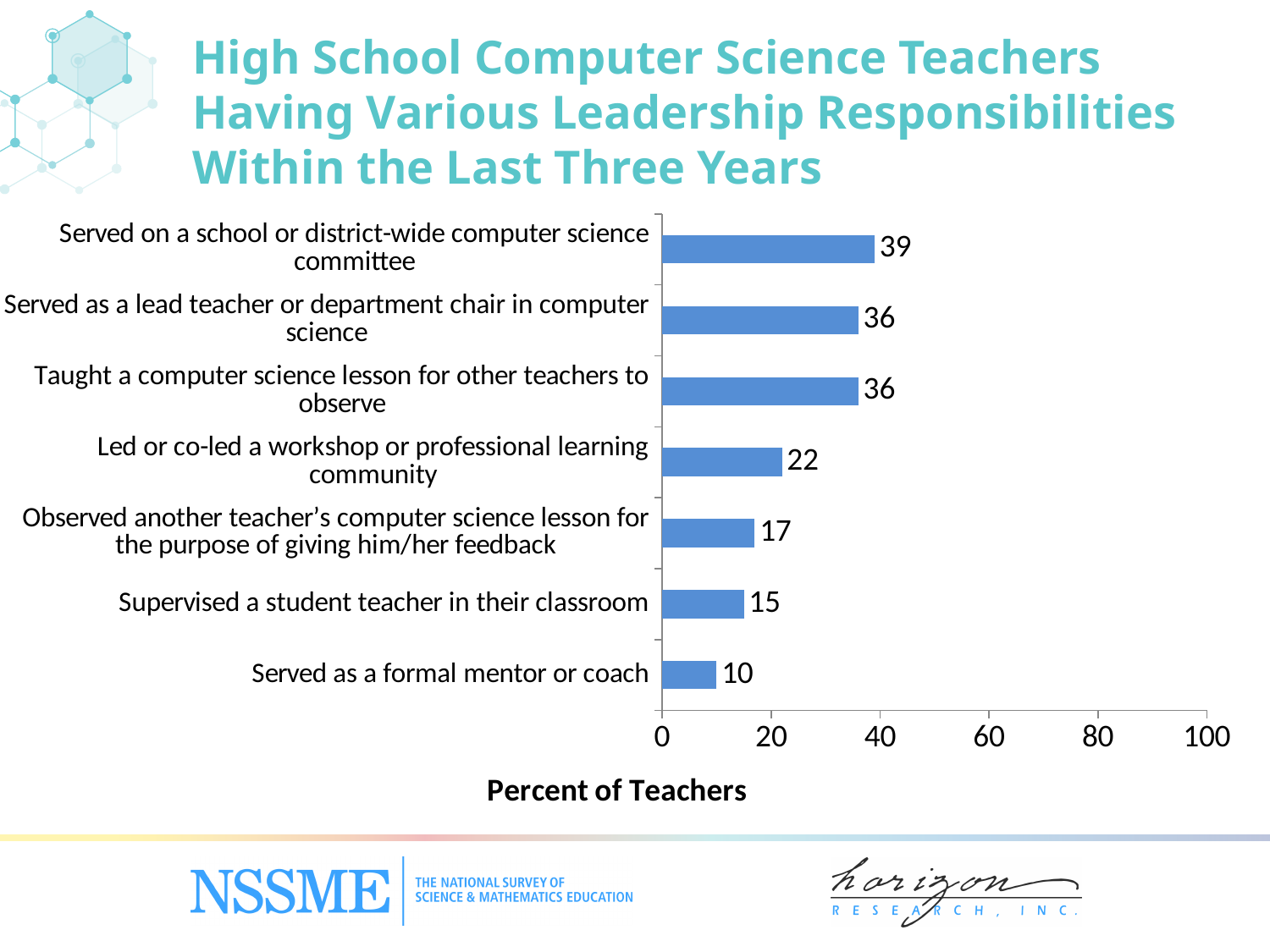
What kind of chart is shown on the slide? Bar chart What is the label of the horizontal axis? Percent of Teachers What percent of teachers served as a formal mentor or coach? 10 What percent of teachers led or co-led a workshop or professional learning community? 22 What is the difference in percent of teachers between leading or co-leading a workshop or professional learning community and observing another teacher's computer science lesson for the purpose of giving feedback? 5 Which leadership responsibility has the highest percent of teachers? Served on a school or district-wide computer science committee What percent of teachers supervised a student teacher in their classroom? 15 Which has a higher percent of teachers: supervising a student teacher in their classroom or leading or co-leading a workshop or professional learning community? Led or co-led a workshop or professional learning community Which leadership responsibility has the lowest percent of teachers? Served as a formal mentor or coach What percent of teachers served on a school or district-wide computer science committee? 39 What is the difference in percent of teachers between serving on a school or district-wide computer science committee and serving as a formal mentor or coach? 29 How many leadership responsibilities are shown in the chart? 7